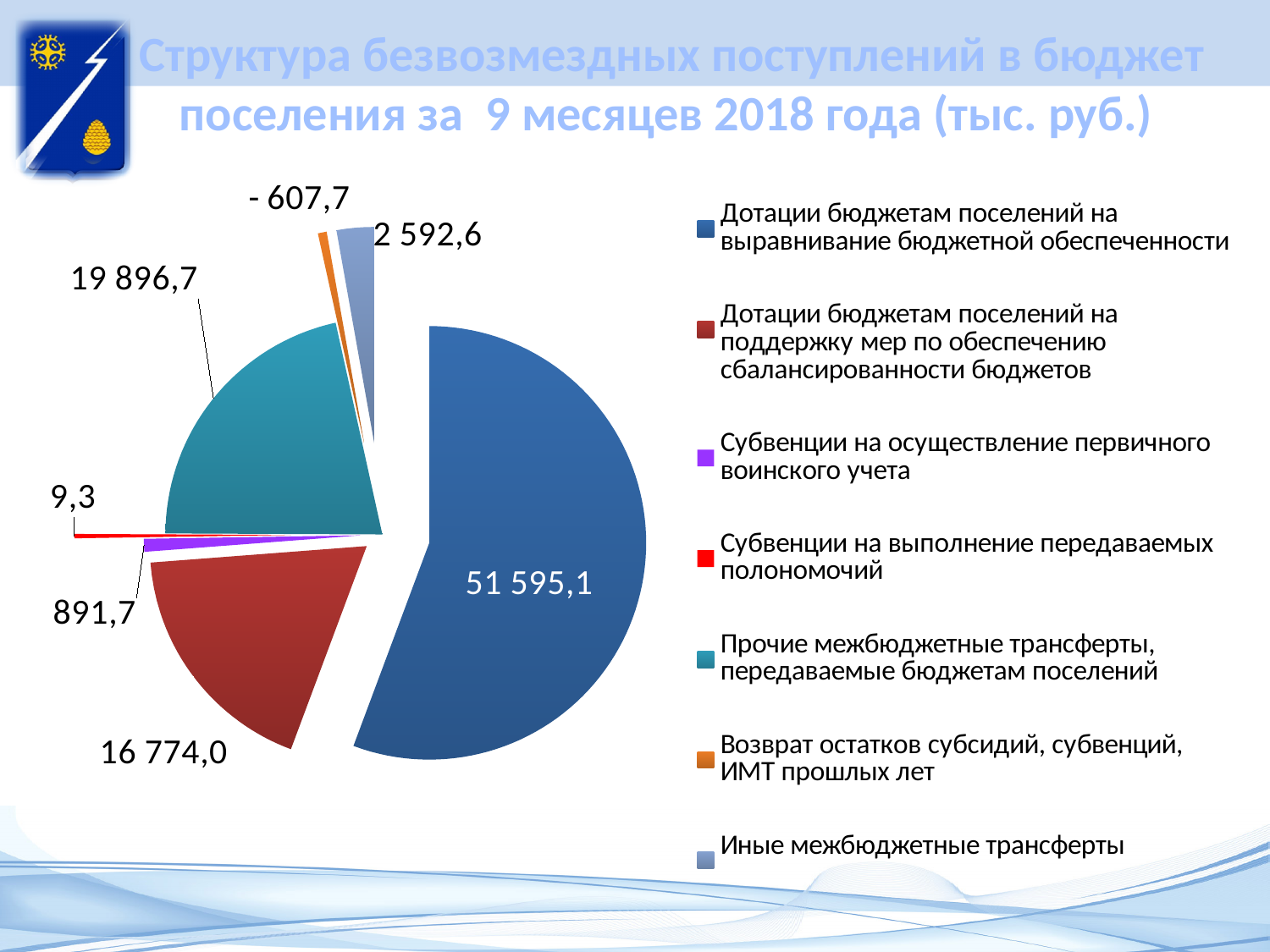
What is the value for «Субвенции на осуществление первичного воинского учета»? 891,7 What is the difference between the values for «Дотации бюджетам поселений на выравнивание бюджетной обеспеченности» and «Дотации бюджетам поселений на поддержку мер по обеспечению сбалансированности бюджетов»? 34 821,1 How many categories does the legend of the pie chart list? 7 What kind of chart is shown on the slide? Pie chart What is the value for «Иные межбюджетные трансферты»? 2 592,6 Which category has the largest value in the pie chart? Дотации бюджетам поселений на выравнивание бюджетной обеспеченности What is the value for «Возврат остатков субсидий, субвенций, ИМТ прошлых лет»? - 607,7 What is the value for «Дотации бюджетам поселений на выравнивание бюджетной обеспеченности»? 51 595,1 Which is larger: «Прочие межбюджетные трансферты, передаваемые бюджетам поселений» or «Дотации бюджетам поселений на поддержку мер по обеспечению сбалансированности бюджетов»? Прочие межбюджетные трансферты, передаваемые бюджетам поселений What is the value for «Прочие межбюджетные трансферты, передаваемые бюджетам поселений»? 19 896,7 What is the value for «Дотации бюджетам поселений на поддержку мер по обеспечению сбалансированности бюджетов»? 16 774,0 Which category has the lowest value in the pie chart? Возврат остатков субсидий, субвенций, ИМТ прошлых лет